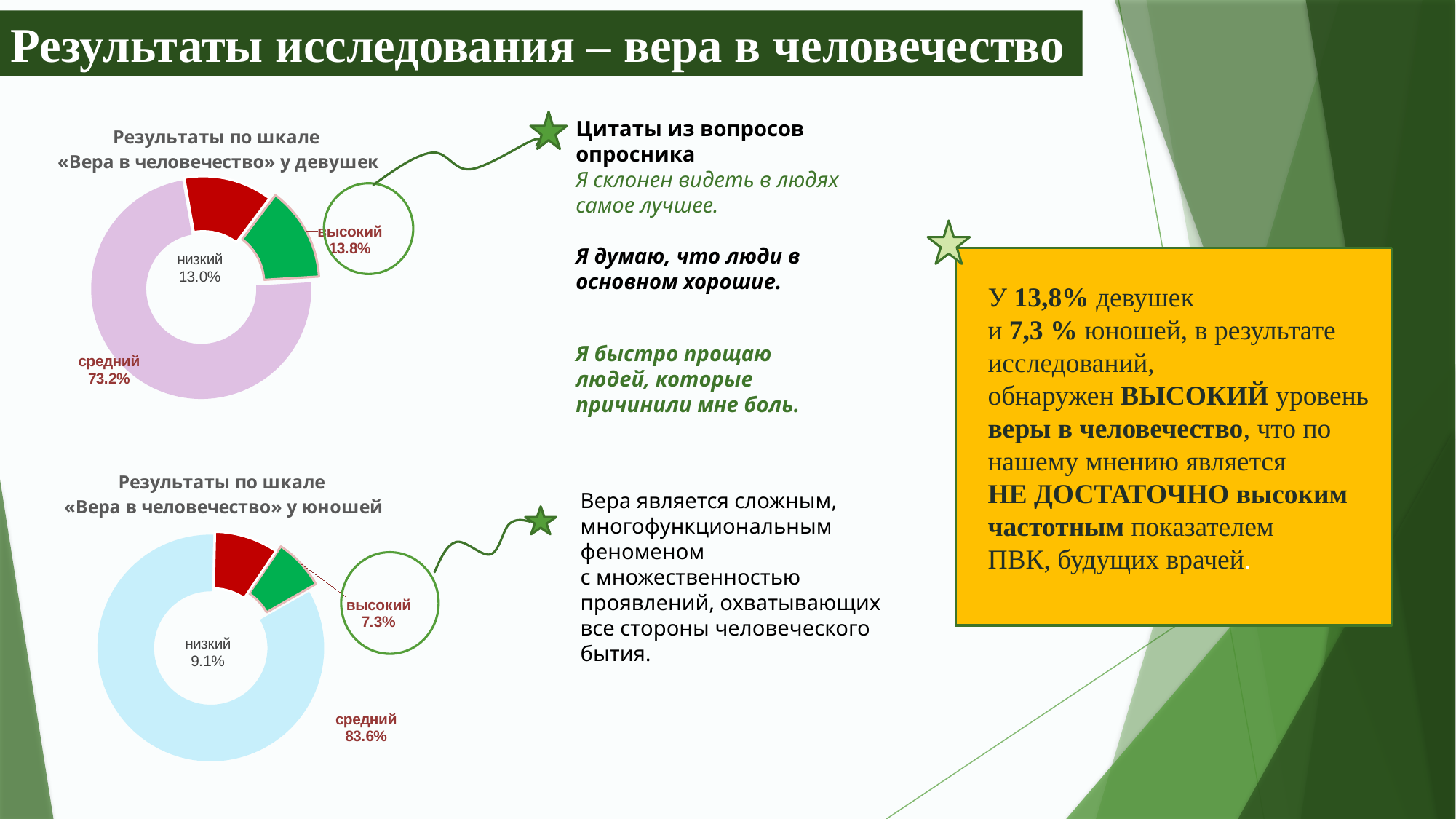
In the chart «Результаты по шкале «Вера в человечество» у юношей», what is the value for «высокий»? 7.3% In the chart «Результаты по шкале «Вера в человечество» у юношей», what is the difference between «низкий» and «высокий»? 1.8% In the chart «Результаты по шкале «Вера в человечество» у девушек», which category has the largest share? средний How many categories are shown in the chart «Результаты по шкале «Вера в человечество» у юношей»? 3 In the chart «Результаты по шкале «Вера в человечество» у девушек», what is the value for «средний»? 73.2% In the chart «Результаты по шкале «Вера в человечество» у девушек», what is the difference between «средний» and «высокий»? 59.4% In the chart «Результаты по шкале «Вера в человечество» у девушек», what is the value for «низкий»? 13.0% In the chart «Результаты по шкале «Вера в человечество» у юношей», what is the value for «средний»? 83.6% In the chart «Результаты по шкале «Вера в человечество» у юношей», which category has the smallest share? высокий What type of chart is used for «Результаты по шкале «Вера в человечество» у девушек»? Doughnut chart In the chart «Результаты по шкале «Вера в человечество» у девушек», what colour is the «высокий» segment? Green In the chart «Результаты по шкале «Вера в человечество» у девушек», what is the value for «высокий»? 13.8%